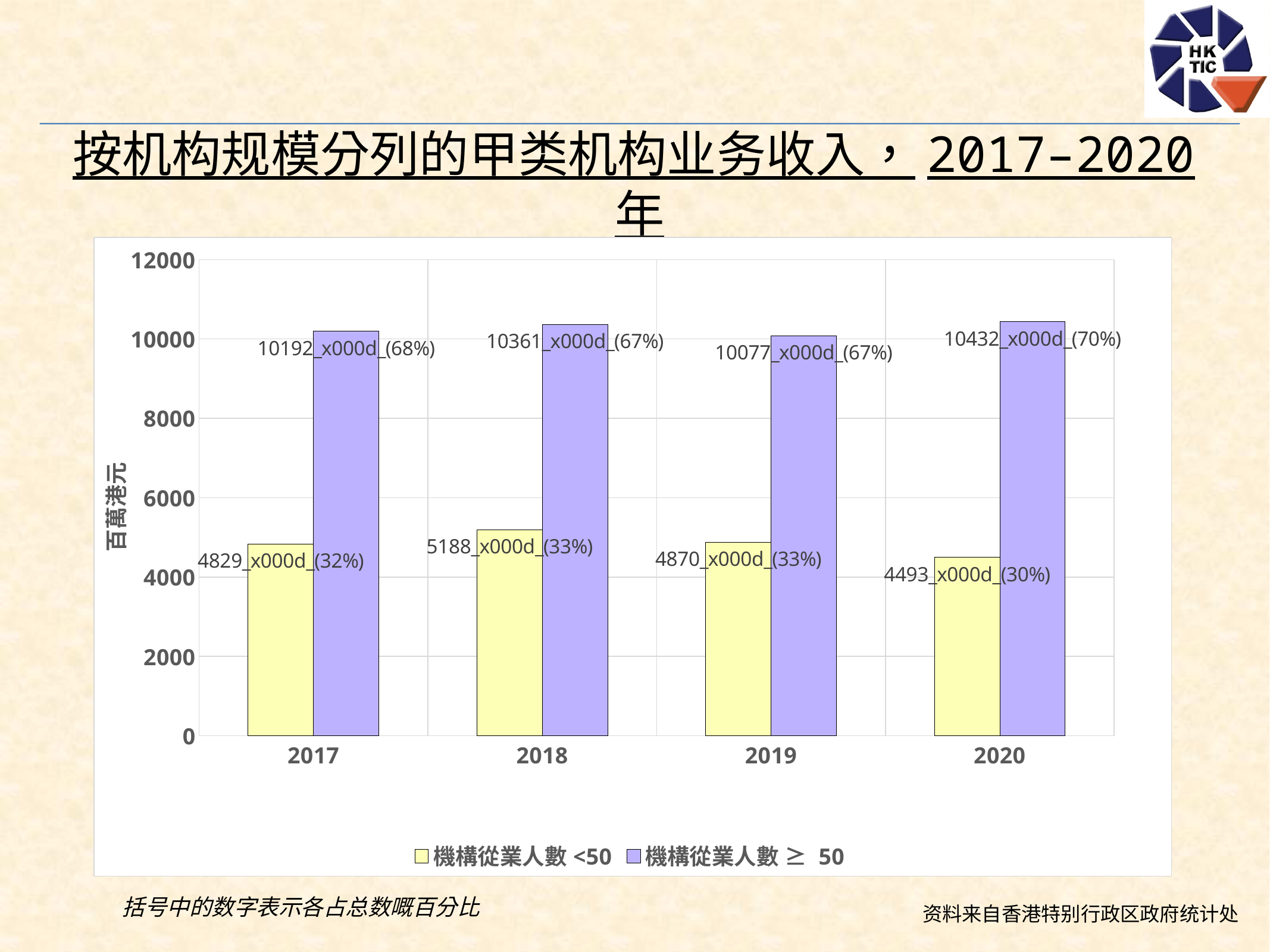
What is the value (in 百萬港元) for 機構從業人數 <50 in 2017? 4829 In which year is the value for 機構從業人數 <50 the highest? 2018 In which year is the value for 機構從業人數 ≥ 50 the lowest? 2019 What percentage share is shown in parentheses for 機構從業人數 ≥ 50 in 2018? 67% What is the difference between the 機構從業人數 ≥ 50 value and the 機構從業人數 <50 value in 2019? 5207 What is the value (in 百萬港元) for 機構從業人數 ≥ 50 in 2020? 10432 Which is larger in 2020: the value for 機構從業人數 <50 or for 機構從業人數 ≥ 50? 機構從業人數 ≥ 50 What type of chart is shown on the slide? bar chart How many years are shown on the x axis? 4 What percentage share is shown in parentheses for 機構從業人數 <50 in 2020? 30% Which colour represents the 機構從業人數 ≥ 50 series? purple How many series does the legend list? 2